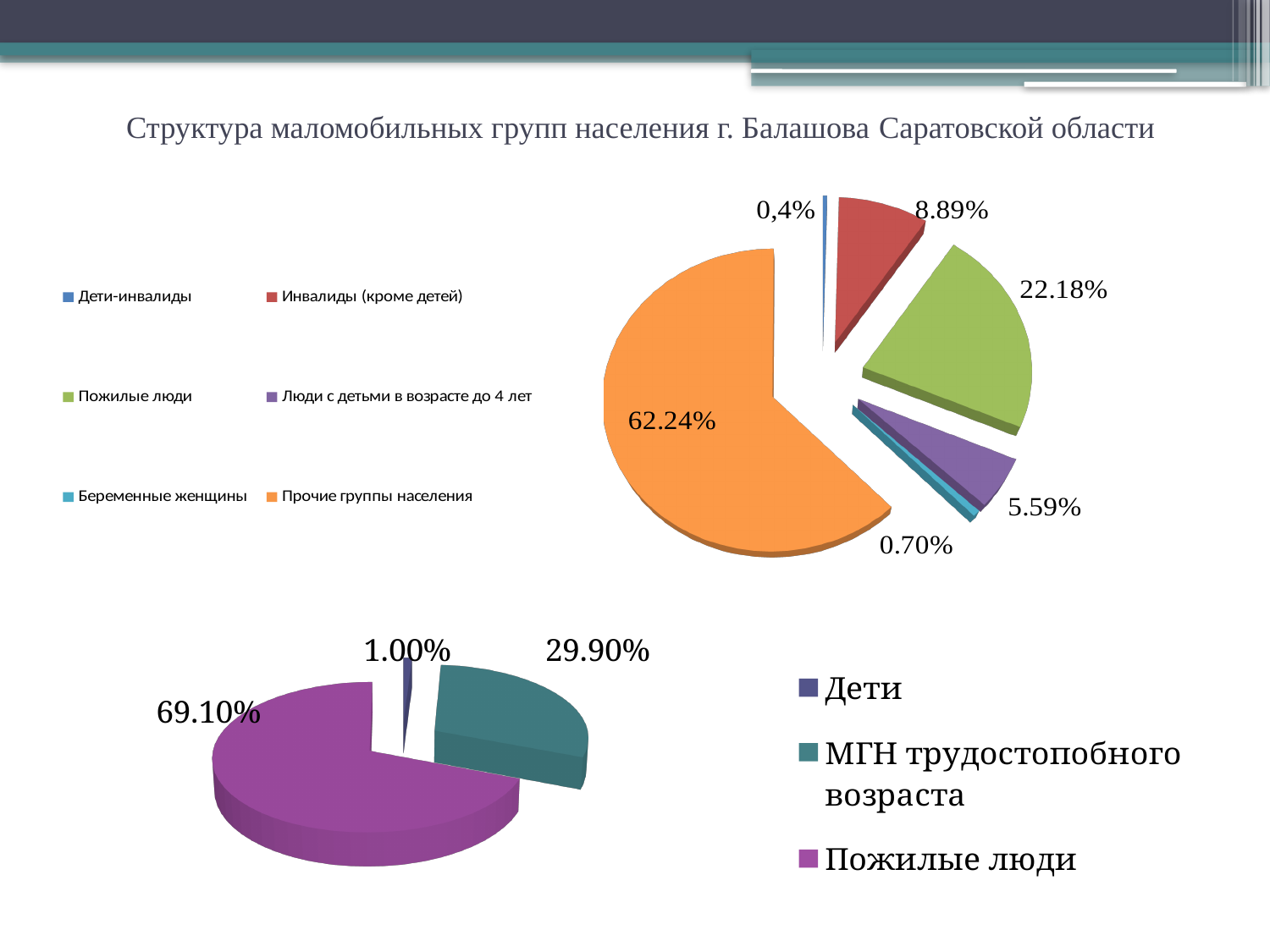
In the top pie chart, how many categories does the legend list? 6 In the top pie chart, which category has the smallest share? Дети-инвалиды In the bottom pie chart, what share is shown for Пожилые люди? 69.10% What type of chart is the bottom chart? Pie chart In the top pie chart, what share is shown for Инвалиды (кроме детей)? 8.89% In the top pie chart, which is larger: Люди с детьми в возрасте до 4 лет or Беременные женщины? Люди с детьми в возрасте до 4 лет In the top pie chart, what share is shown for Прочие группы населения? 62.24% In the top pie chart, what share is shown for Пожилые люди? 22.18% In the bottom pie chart, what share is shown for МГН трудостопобного возраста? 29.90% In the top pie chart, what is the difference between the shares of Пожилые люди and Инвалиды (кроме детей)? 13.29% In the bottom pie chart, which category has the smallest share? Дети In the top pie chart, which category has the largest share? Прочие группы населения